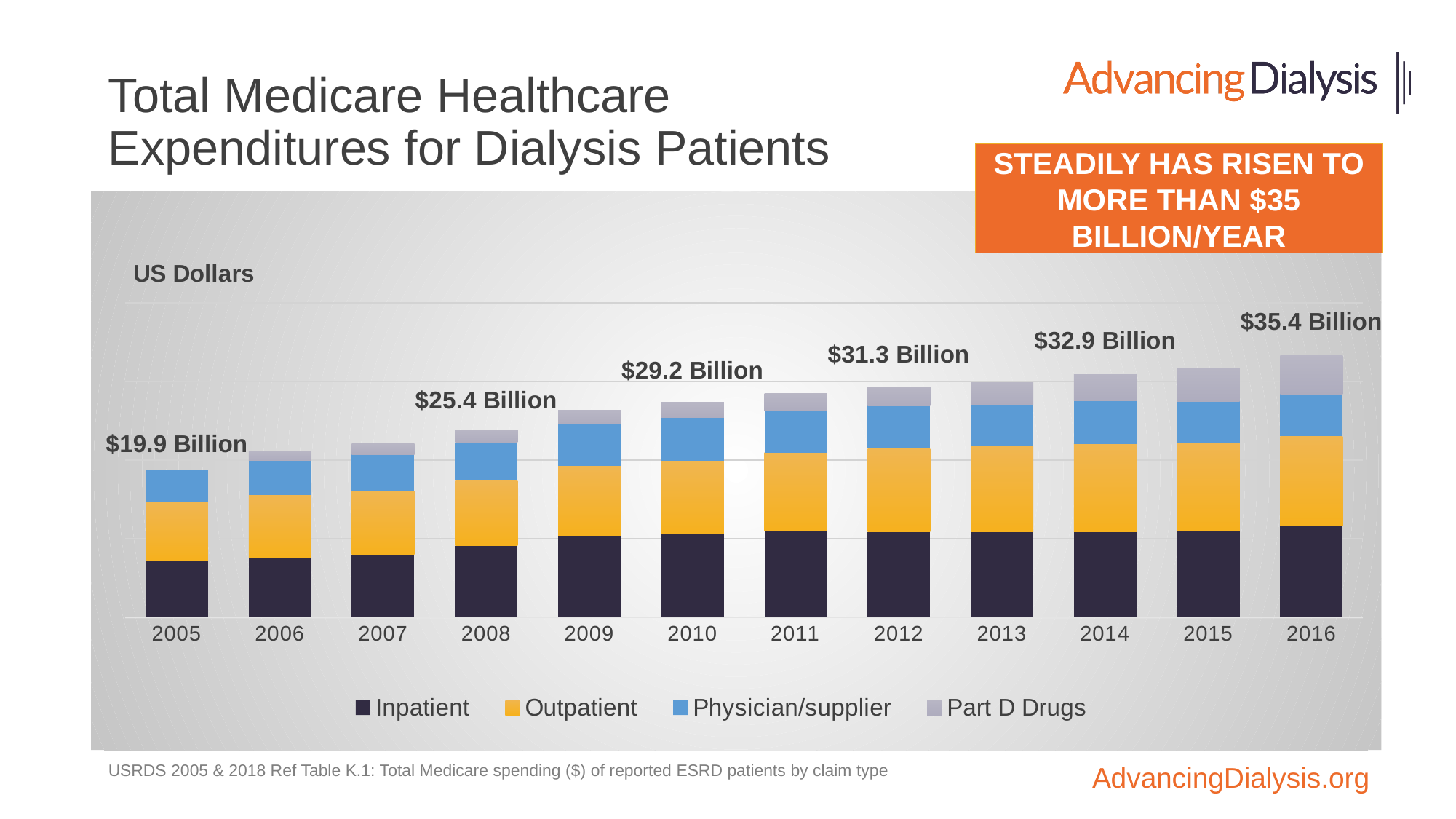
Which year has the lowest total expenditure? 2005 How many years are shown on the x axis? 12 How much higher is the labelled total for 2016 than for 2005? $15.5 Billion What is the difference between the labelled totals for 2014 and 2010? $3.7 Billion What total is labelled above the 2008 bar? $25.4 Billion Which year has the highest total expenditure? 2016 Which year has the larger total expenditure, 2009 or 2013? 2013 What total is labelled above the 2012 bar? $31.3 Billion What is the total Medicare expenditure shown for 2016? $35.4 Billion What is the total Medicare expenditure shown for 2005? $19.9 Billion Do total expenditures rise or fall from 2005 to 2016? Rise How many series does the legend list? 4